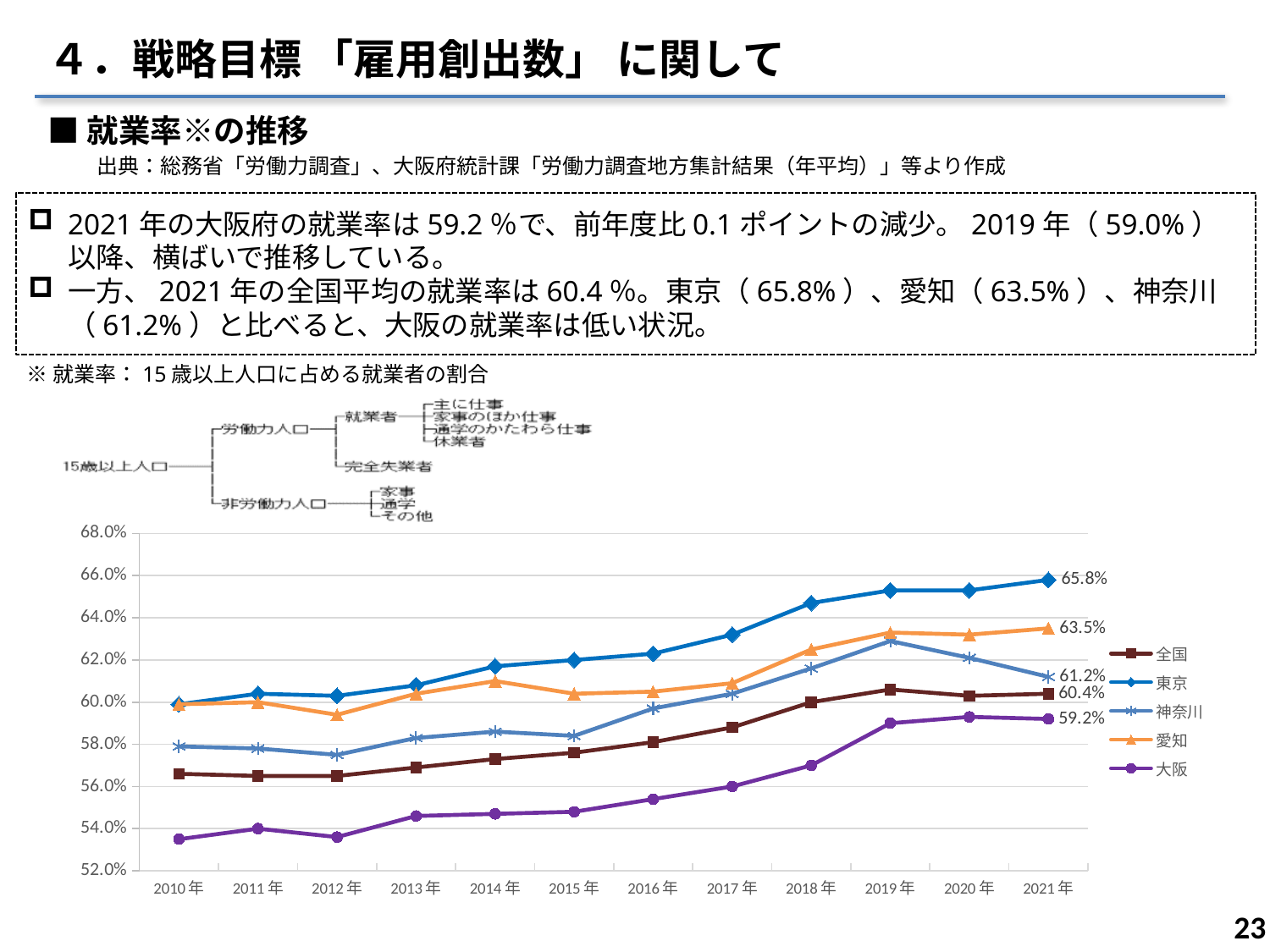
What is the value for 大阪 in 2021年? 59.2% What kind of chart is shown on the slide? line chart What is the value for 東京 in 2021年? 65.8% How many years are plotted along the x axis? 12 What is the value for 全国 in 2021年? 60.4% Which series has the highest value in 2021年? 東京 Is the value for 大阪 in 2010年 greater or less than 54.0%? less Which series has the lowest value in 2021年? 大阪 Does the 東京 series generally rise or fall from 2010年 to 2021年? rise What is the value for 愛知 in 2021年? 63.5% What is the difference between the 2021年 values for 東京 and 大阪? 6.6 points How many series does the legend list? 5